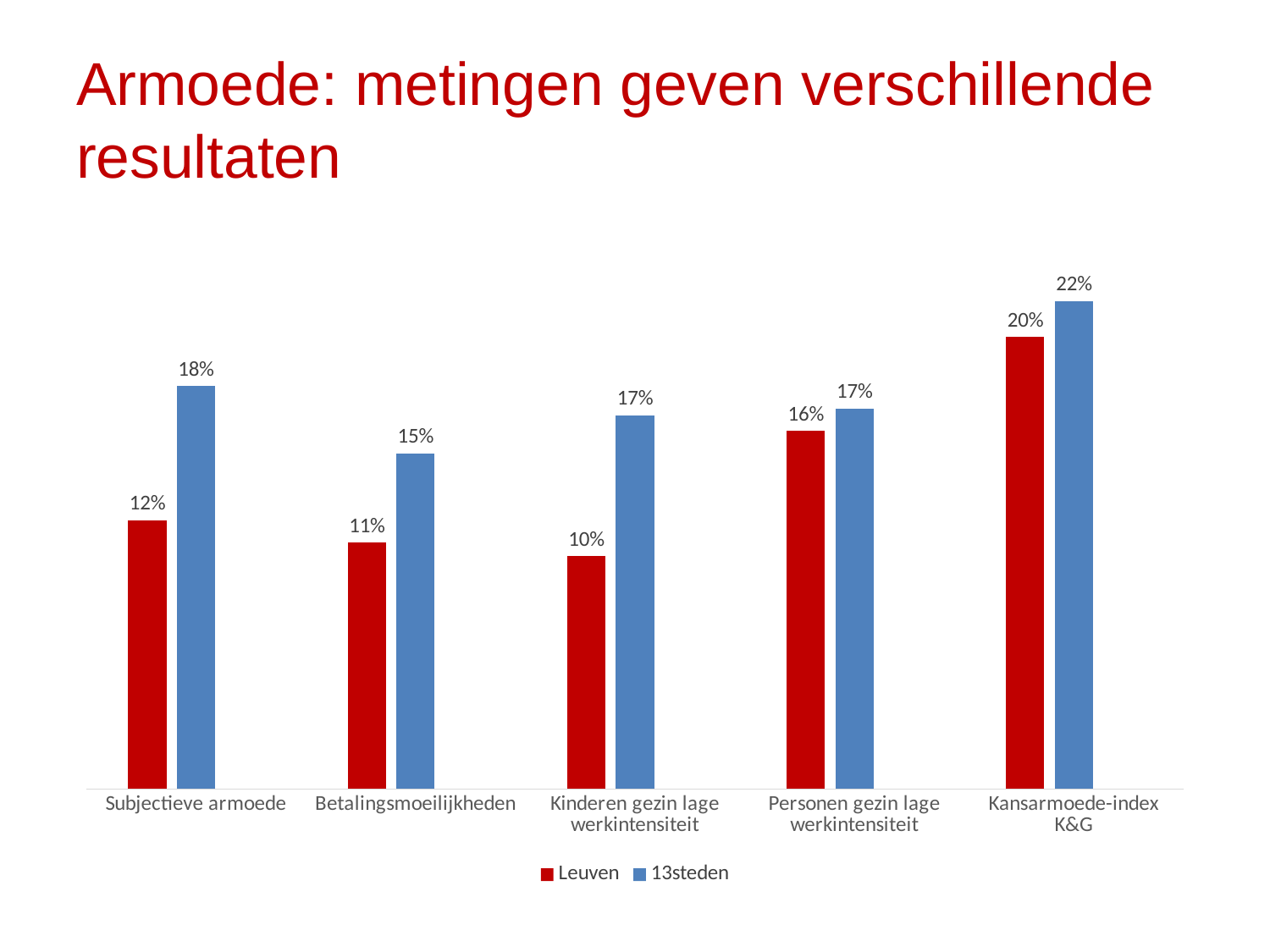
What kind of chart is shown on the slide? Bar chart Which is larger for Subjectieve armoede: the Leuven value or the 13steden value? 13steden Which category has the lowest value for 13steden? Betalingsmoeilijkheden What is the value for Leuven for Kinderen gezin lage werkintensiteit? 10% What is the value for 13steden for Betalingsmoeilijkheden? 15% Which category has the highest value for Leuven? Kansarmoede-index K&G Which colour represents the Leuven series? Red What is the value for 13steden for Kansarmoede-index K&G? 22% How many categories are shown on the x axis? 5 What is the value for Leuven for Subjectieve armoede? 12% How many series does the legend list? 2 What is the difference between the 13steden and Leuven values for Kinderen gezin lage werkintensiteit? 7%